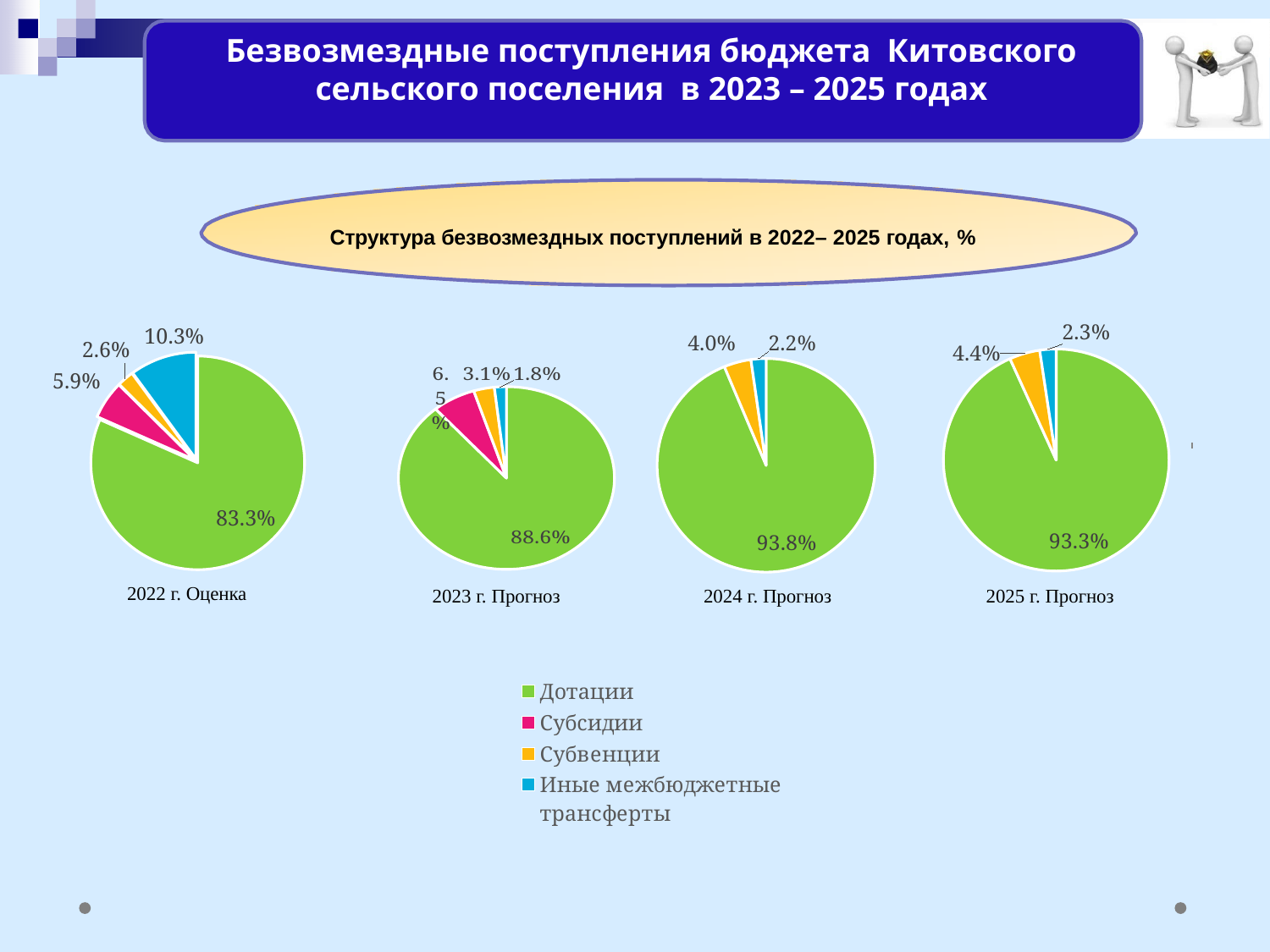
In the 2022 г. Оценка pie chart, what is the share of Иные межбюджетные трансферты? 10.3% In the 2024 г. Прогноз pie chart, what is the share of Субвенции? 4.0% How many series does the legend list? 4 In the 2022 г. Оценка pie chart, what is the share of Дотации? 83.3% In the 2022 г. Оценка pie chart, what is the share of Субсидии? 5.9% What kind of charts are shown on the slide? Pie charts What is the difference between the Дотации share in the 2024 г. Прогноз chart and in the 2022 г. Оценка chart? 10.5% In the 2025 г. Прогноз pie chart, which category has the largest share? Дотации How many pie charts are on the slide? 4 In the 2023 г. Прогноз pie chart, what is the share of Субвенции? 3.1% In the 2025 г. Прогноз pie chart, what is the share of Иные межбюджетные трансферты? 2.3% In the 2023 г. Прогноз pie chart, what is the share of Дотации? 88.6%